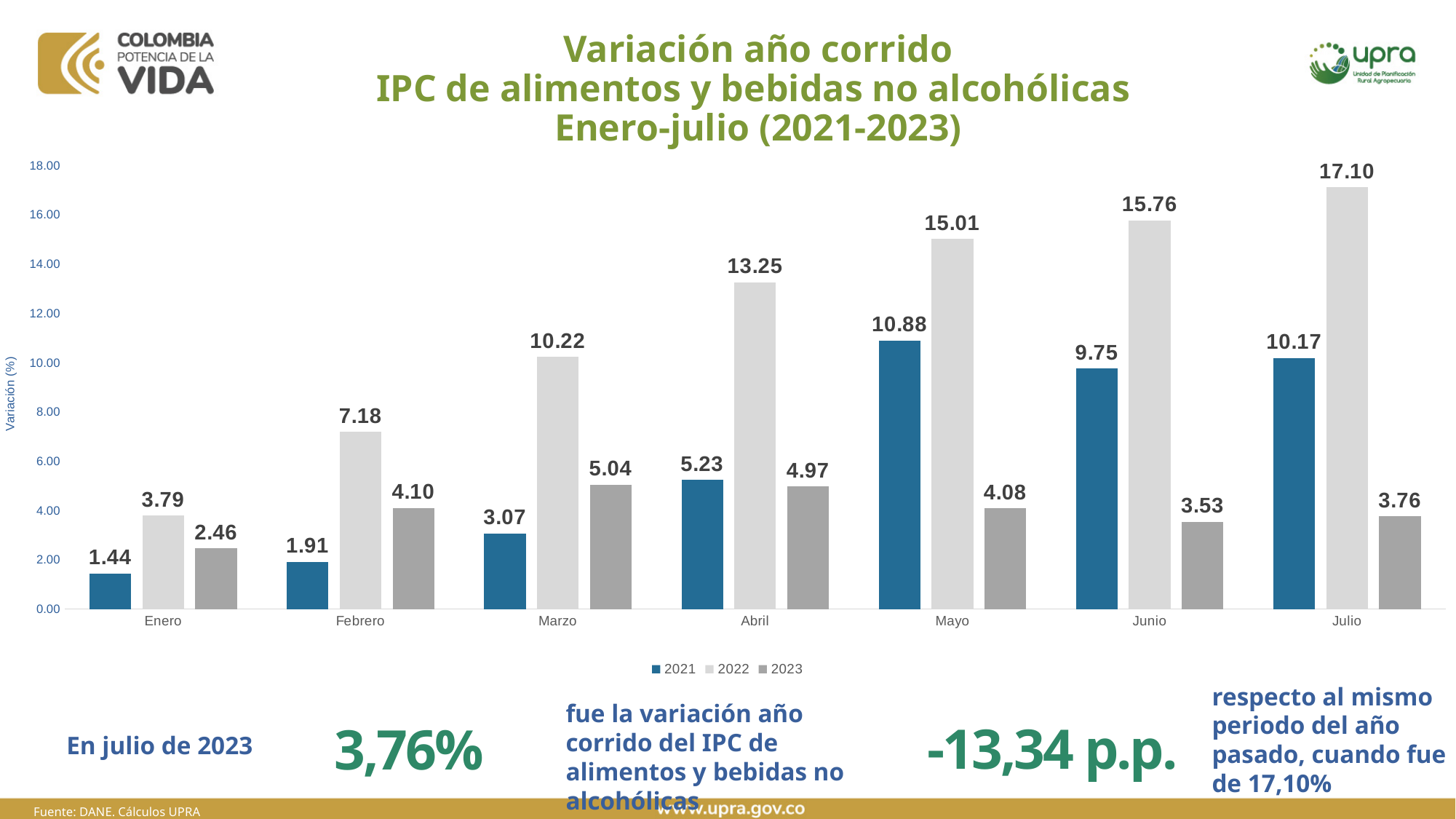
What is the value for 2022 in Julio? 17.10 Which month has the highest value for the 2022 series? Julio Which is larger in Mayo: the 2021 value or the 2023 value? 2021 How many series does the legend list? 3 What is the label of the y axis? Variación (%) Do the values for the 2022 series rise or fall from Enero to Julio? Rise How many months are shown on the x axis? 7 Which month has the lowest value for the 2023 series? Enero What is the value for 2023 in Abril? 4.97 What is the difference between the 2022 and 2023 values in Julio? 13.34 What kind of chart is shown on the slide? Bar chart What is the value for 2021 in Enero? 1.44